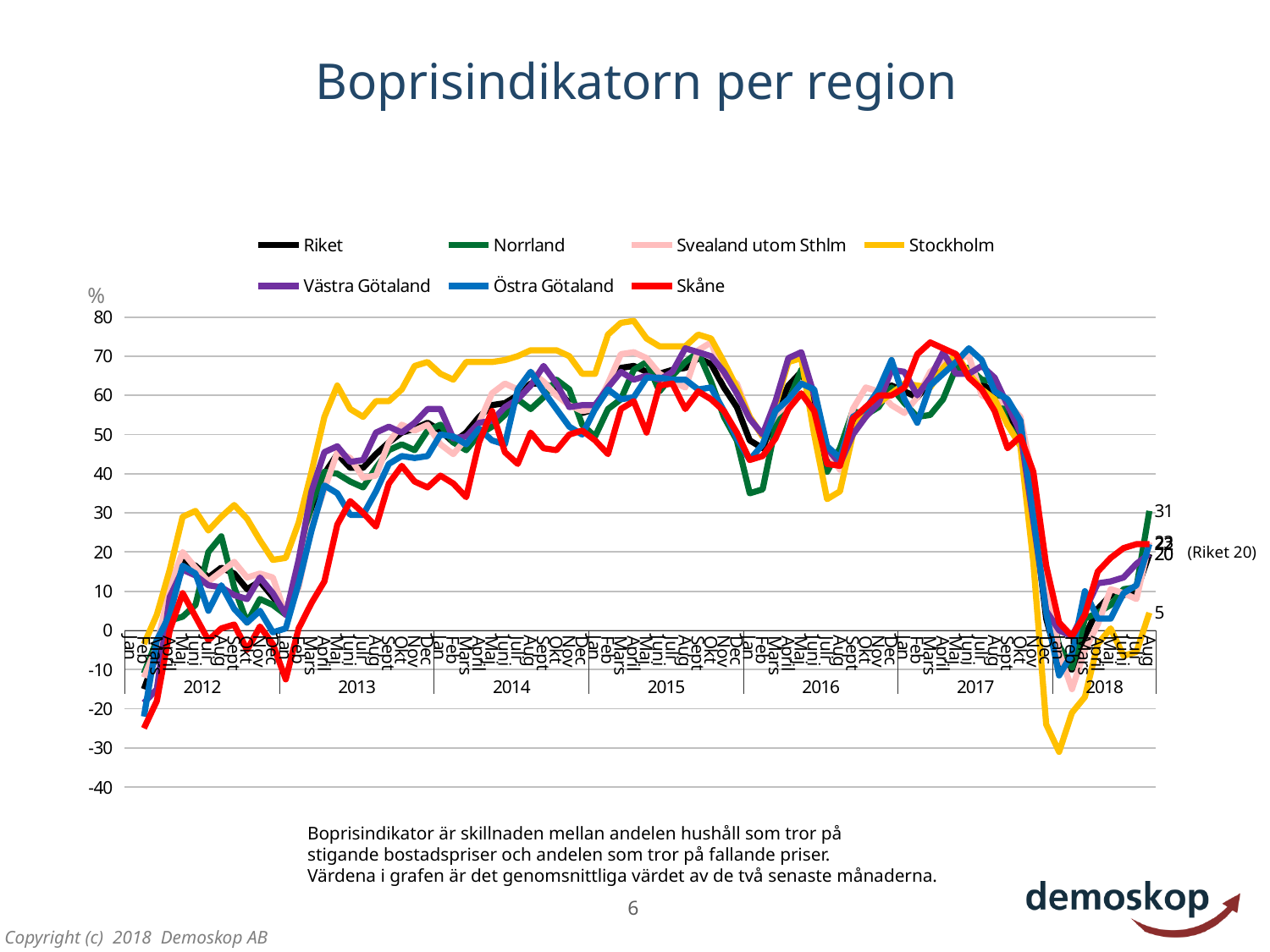
How many series does the legend list? 7 Which region has the highest value at the right end of the chart? Norrland Is the lowest point of the Stockholm line in 2018 greater or less than -20? less What kind of chart is shown on the slide? line chart What is the latest (rightmost) value labelled for Stockholm? 5 What is the latest value for Riket according to the annotation on the chart? 20 Is the highest point of the Stockholm line greater or less than 70? greater Which region has the lowest value at the right end of the chart? Stockholm What is the latest (rightmost) value labelled for Norrland? 31 What is the title of the chart? Boprisindikatorn per region What is the difference between the latest labelled values for Norrland and Stockholm? 26 Do the values generally rise or fall from the start of 2012 to 2015? rise